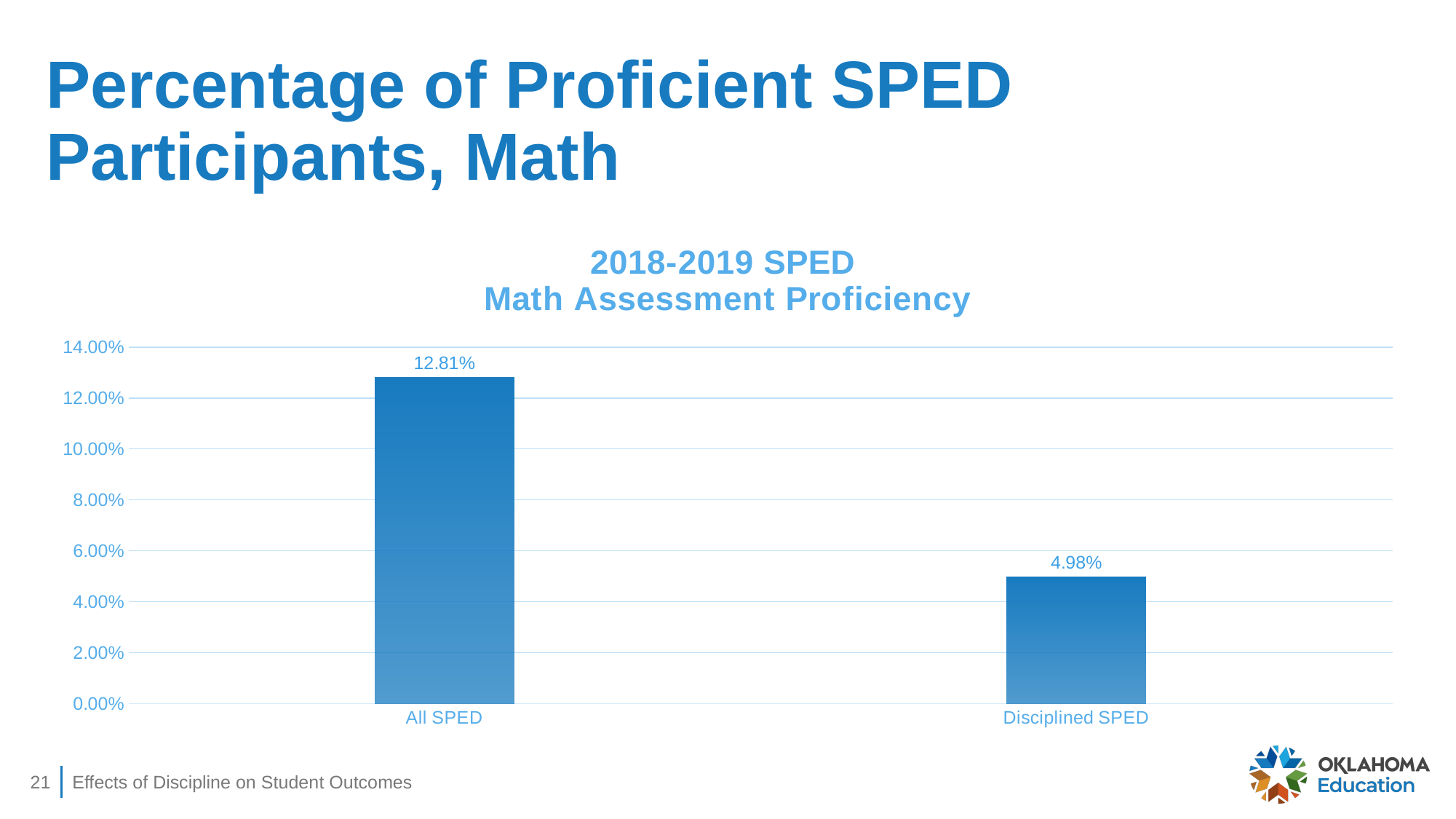
Is the value for All SPED greater or less than 12.00%? greater How many categories are shown on the chart? 2 What is the difference between the values for All SPED and Disciplined SPED? 7.83% Which category has the lowest value? Disciplined SPED What is the value for All SPED? 12.81% What is the highest value shown on the y axis? 14.00% What is the title of the chart? 2018-2019 SPED Math Assessment Proficiency Which category has the highest value? All SPED Which is larger, the value for All SPED or the value for Disciplined SPED? All SPED Is the value for Disciplined SPED greater or less than 6.00%? less What kind of chart is shown on the slide? bar chart What is the value for Disciplined SPED? 4.98%